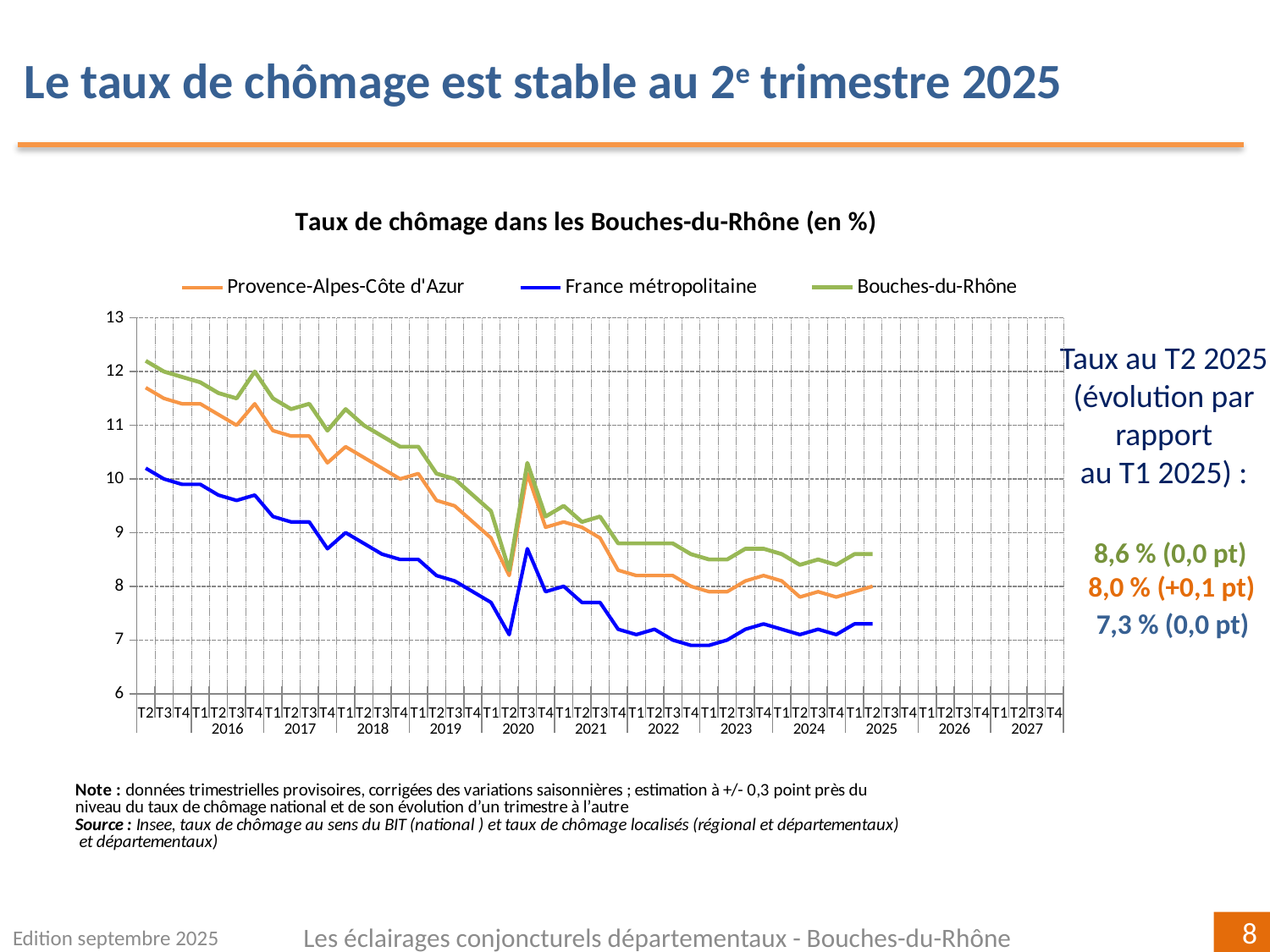
Overall, do the unemployment rates rise or fall between 2016 and 2025? Fall Which series has the lowest value at T2 2025? France métropolitaine What is the difference between the Bouches-du-Rhône rate and the France métropolitaine rate at T2 2025? 1,3 points By how much did the Provence-Alpes-Côte d'Azur rate change between T1 2025 and T2 2025? +0,1 pt What is the title of the chart? Taux de chômage dans les Bouches-du-Rhône (en %) What is the unemployment rate for Bouches-du-Rhône at T2 2025? 8,6 % Which series is drawn in blue on the chart? France métropolitaine How many series does the legend of the chart list? 3 What is the unemployment rate for France métropolitaine at T2 2025? 7,3 % Which series has the highest value at T2 2025? Bouches-du-Rhône What kind of chart is shown on the slide? Line chart What is the unemployment rate for Provence-Alpes-Côte d'Azur at T2 2025? 8,0 %